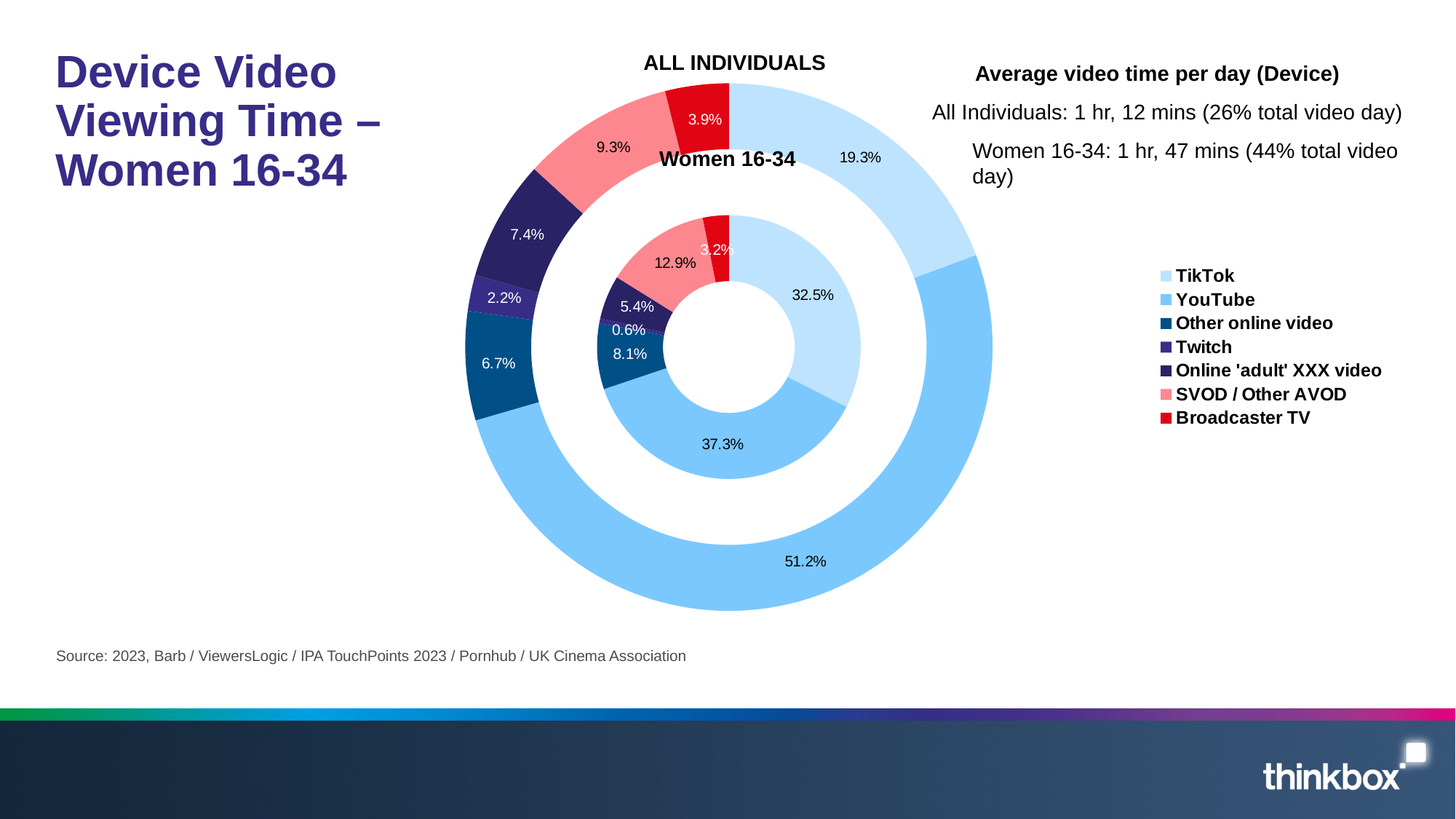
In the inner ring (Women 16-34), what share does SVOD / Other AVOD have? 12.9% Which category has the smallest share in the inner ring (Women 16-34)? Twitch How many categories does the legend list? 7 Which is larger for Women 16-34: the TikTok share or the YouTube share? YouTube Which category has the largest share in the outer ring (All Individuals)? YouTube What is the difference between the YouTube share for All Individuals (51.2%) and for Women 16-34 (37.3%)? 13.9% In the outer ring (All Individuals), what share does YouTube have? 51.2% Is the Twitch share for All Individuals (2.2%) greater or less than the Twitch share for Women 16-34 (0.6%)? greater What kind of chart is shown on the slide? Doughnut chart Which ring of the doughnut chart represents Women 16-34, the inner or the outer? Inner In the inner ring (Women 16-34), what share does TikTok have? 32.5% In the outer ring (All Individuals), what share does Broadcaster TV have? 3.9%